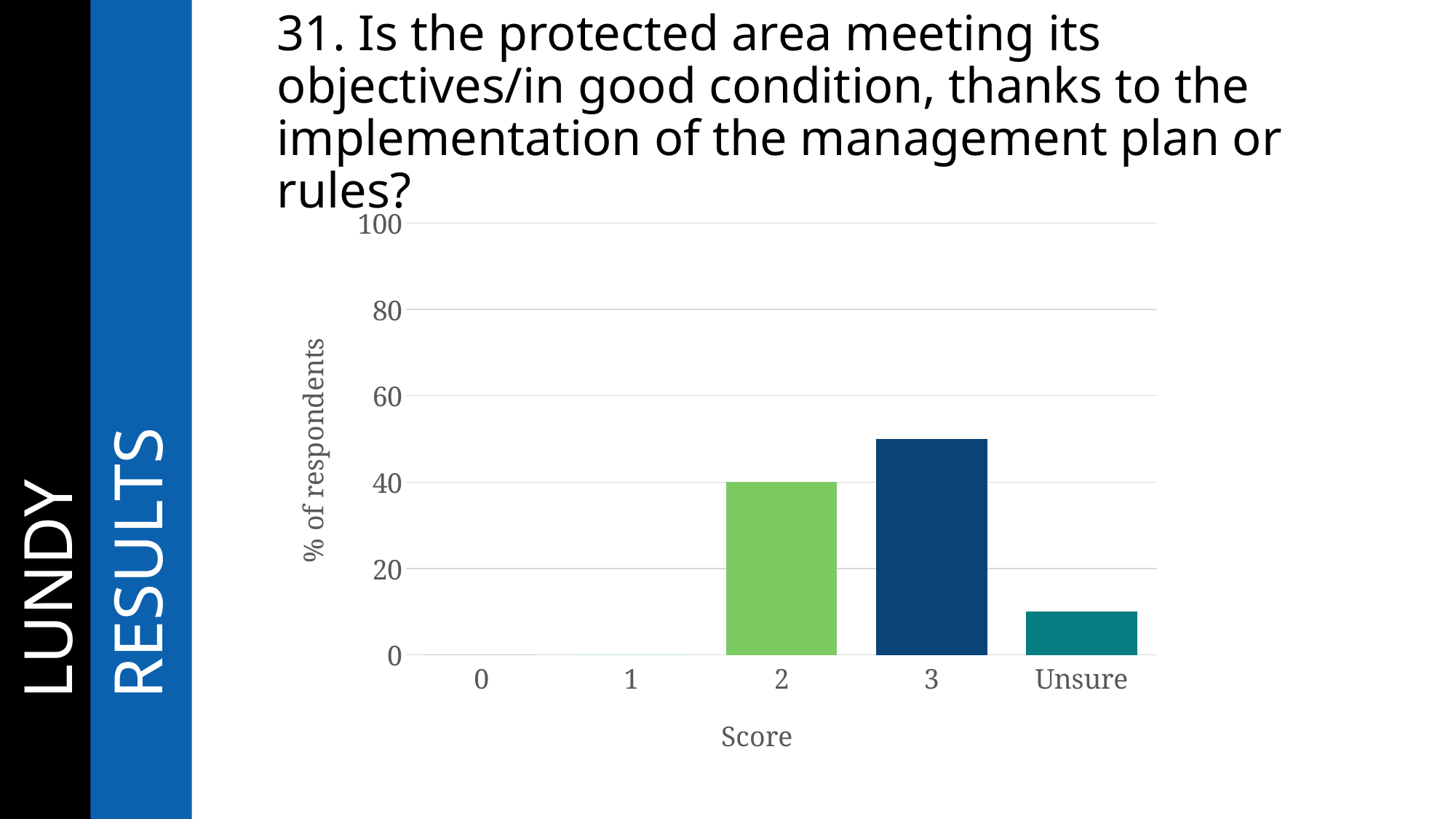
What is the % of respondents for score 0? 0 What is the % of respondents for score 2? 40 Is the value for score 3 greater or less than 40? greater How many score categories have no visible bar (a value of 0)? 2 Which is larger, the value for Unsure or the value for score 2? 2 How many score categories are shown on the x axis? 5 What kind of chart is shown on the slide? bar chart Is the value for score 3 greater or less than 60? less Which is larger, the value for score 2 or the value for score 3? 3 Which score category has the highest percentage of respondents? 3 What is the label on the y axis of the chart? % of respondents Is the value for Unsure greater or less than 20? less